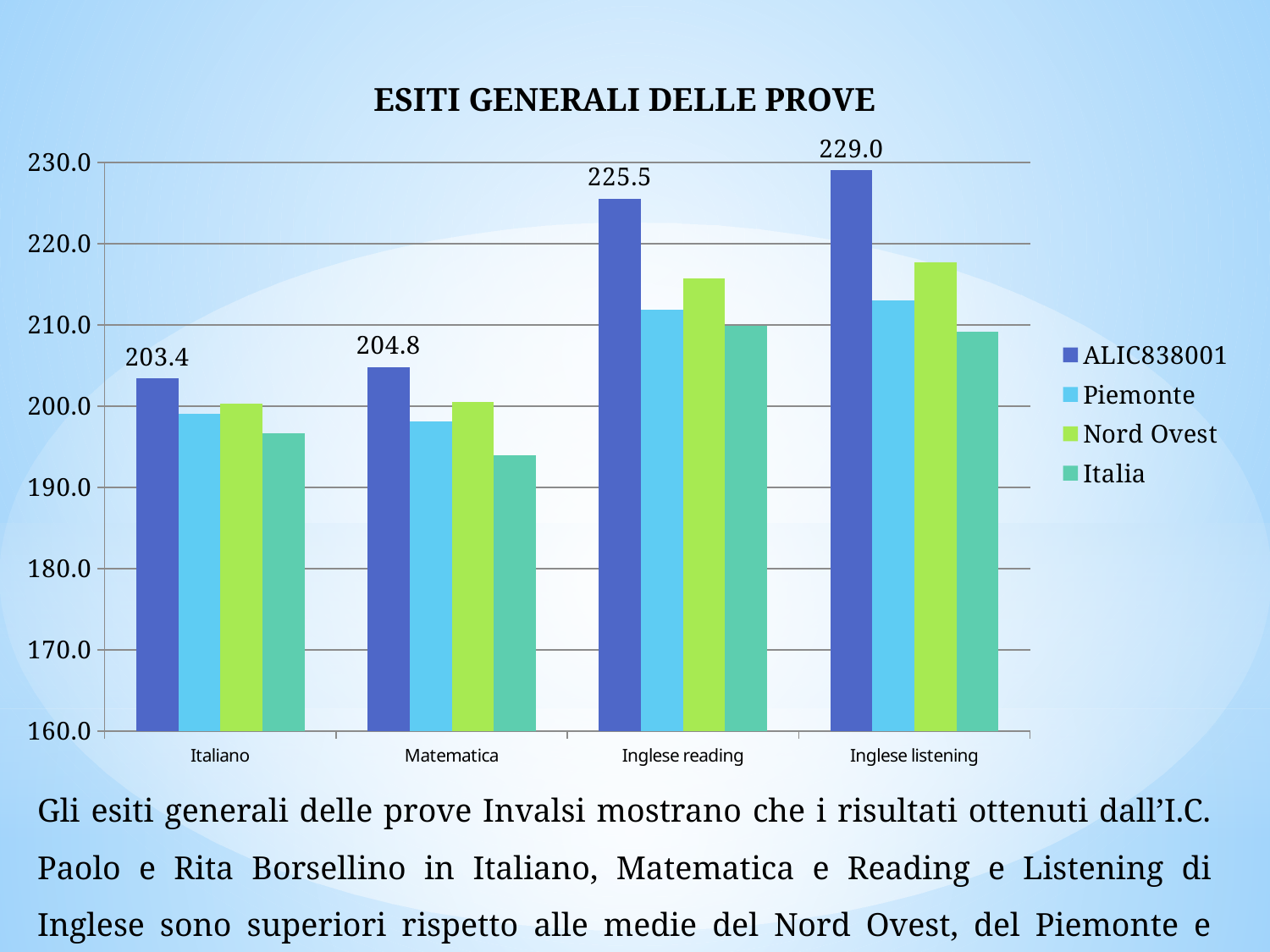
How many series does the legend list? 4 What is the difference between the ALIC838001 values for Inglese listening and Inglese reading? 3.5 What is the value for ALIC838001 in Inglese listening? 229.0 What is the value for ALIC838001 in Inglese reading? 225.5 What is the value for ALIC838001 in Italiano? 203.4 Is the value for Italia in Matematica greater or less than 200.0? less What is the value for ALIC838001 in Matematica? 204.8 In which category does ALIC838001 have its lowest value? Italiano What kind of chart is shown on the slide? Bar chart Is the value for Nord Ovest in Inglese listening greater or less than 210.0? greater In which category does ALIC838001 have its highest value? Inglese listening In Inglese reading, which is larger: the value for ALIC838001 or the value for Italia? ALIC838001